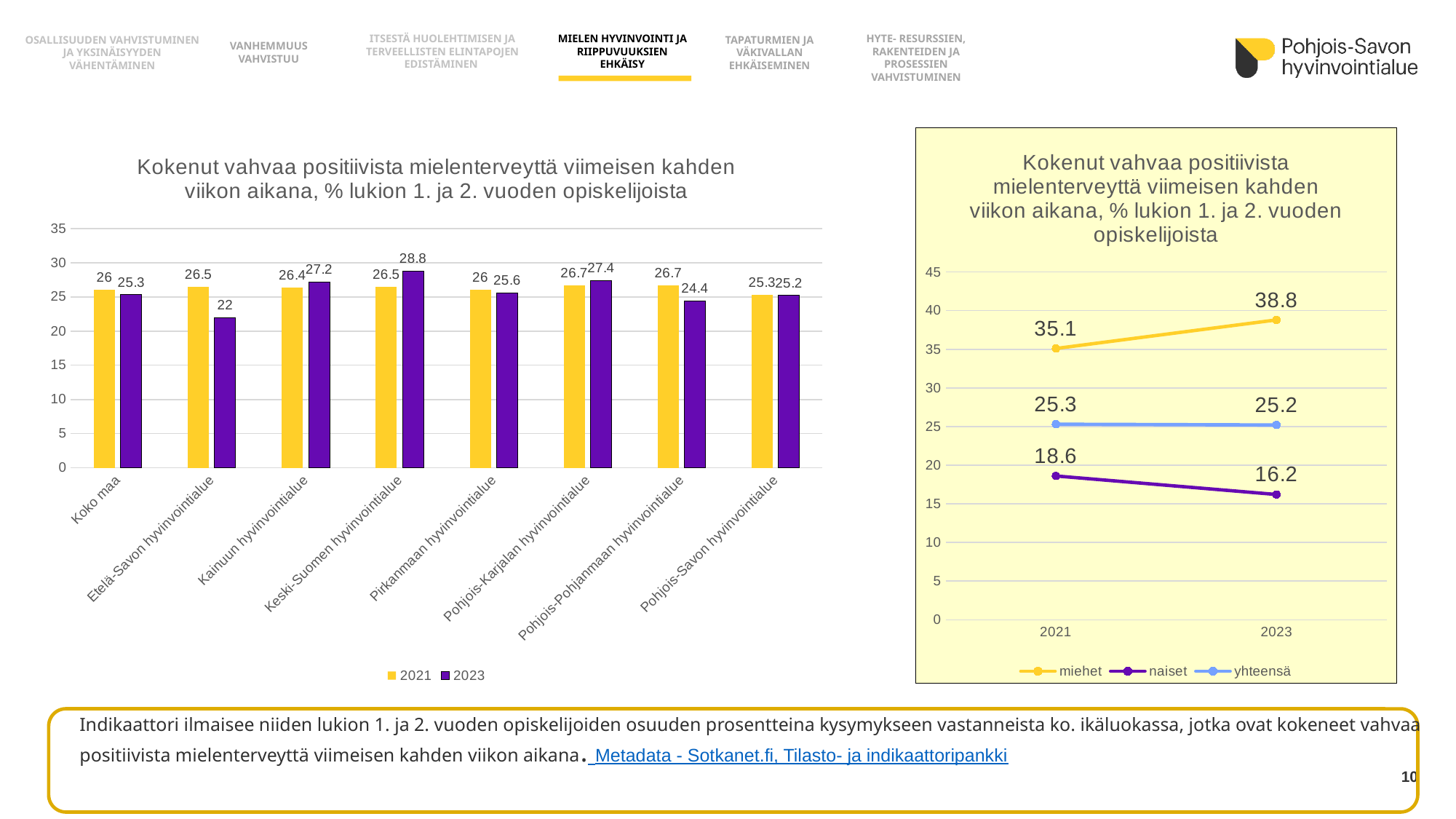
In the line chart on the right, what is the value for miehet in 2023? 38.8 What type of chart is the chart on the right side of the slide? line chart In the line chart on the right, does the naiset series rise or fall from 2021 to 2023? fall In the bar chart on the left, which region has the lowest 2023 value? Etelä-Savon hyvinvointialue In the bar chart on the left, what is the 2023 value for Keski-Suomen hyvinvointialue? 28.8 In the bar chart on the left, which region has the highest 2023 value? Keski-Suomen hyvinvointialue In the bar chart on the left, is the 2023 value for Pohjois-Pohjanmaan hyvinvointialue larger or smaller than its 2021 value? smaller In the line chart on the right, what is the difference between the miehet and naiset values in 2021? 16.5 How many series does the legend of the bar chart on the left list? 2 In the bar chart on the left, what is the 2021 value for Pohjois-Savon hyvinvointialue? 25.3 How many regions are shown on the x axis of the bar chart on the left? 8 In the bar chart on the left, what is the difference between the 2021 and 2023 values for Etelä-Savon hyvinvointialue? 4.5